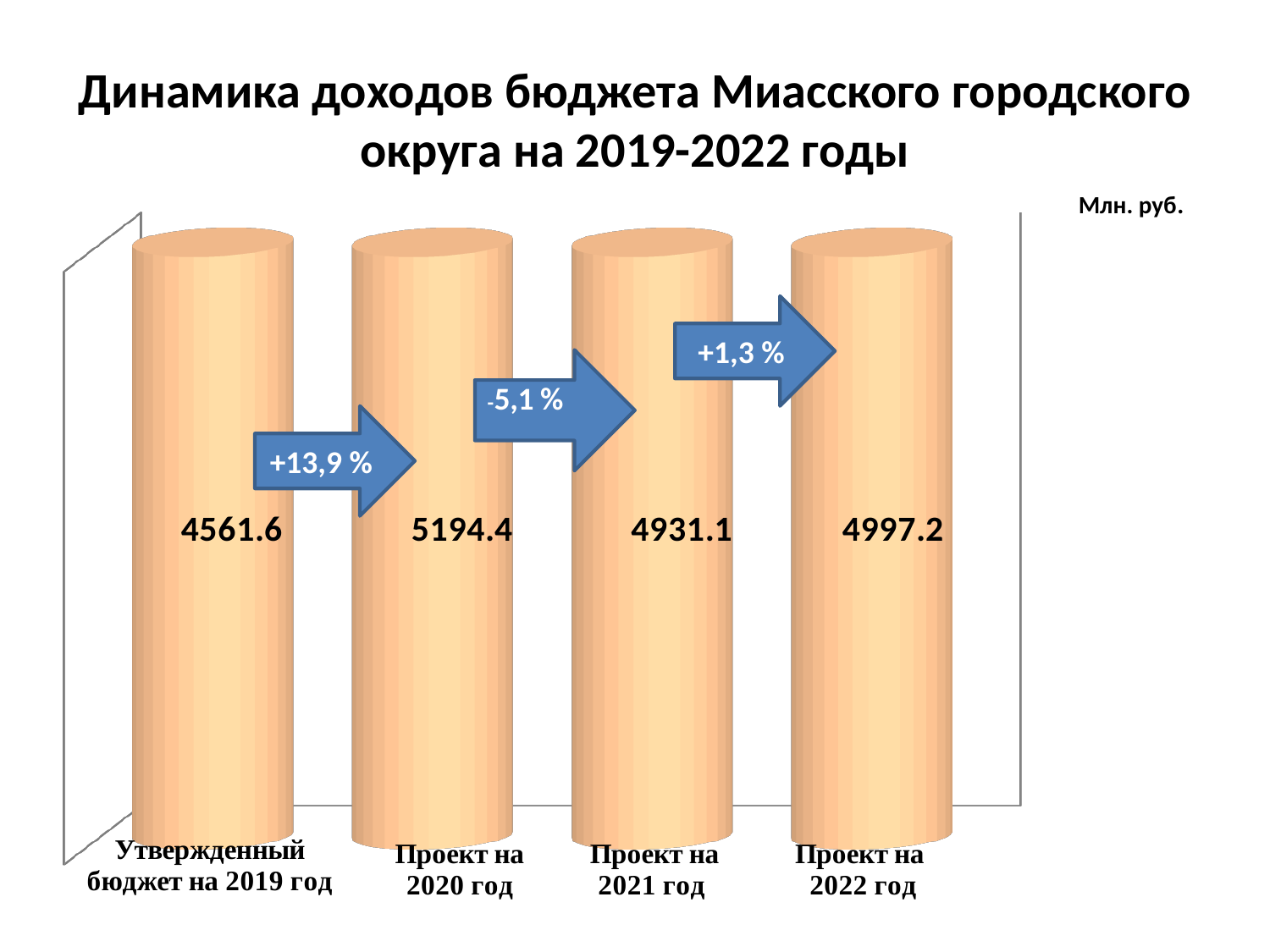
Which category has the lowest value? Утвержденный бюджет на 2019 год What is the difference between the values for 'Проект на 2020 год' and 'Утвержденный бюджет на 2019 год'? 632.8 What percentage change is shown on the arrow between 'Проект на 2020 год' and 'Проект на 2021 год'? -5,1 % What unit is indicated for the values in the chart? Млн. руб. What is the value for 'Проект на 2022 год'? 4997.2 Which is larger: the value for 'Проект на 2021 год' or 'Проект на 2022 год'? Проект на 2022 год What is the value for 'Утвержденный бюджет на 2019 год'? 4561.6 How many categories are shown in the chart? 4 Which category has the highest value? Проект на 2020 год What kind of chart is shown on the slide? Bar chart What is the value for 'Проект на 2021 год'? 4931.1 What is the value for 'Проект на 2020 год'? 5194.4